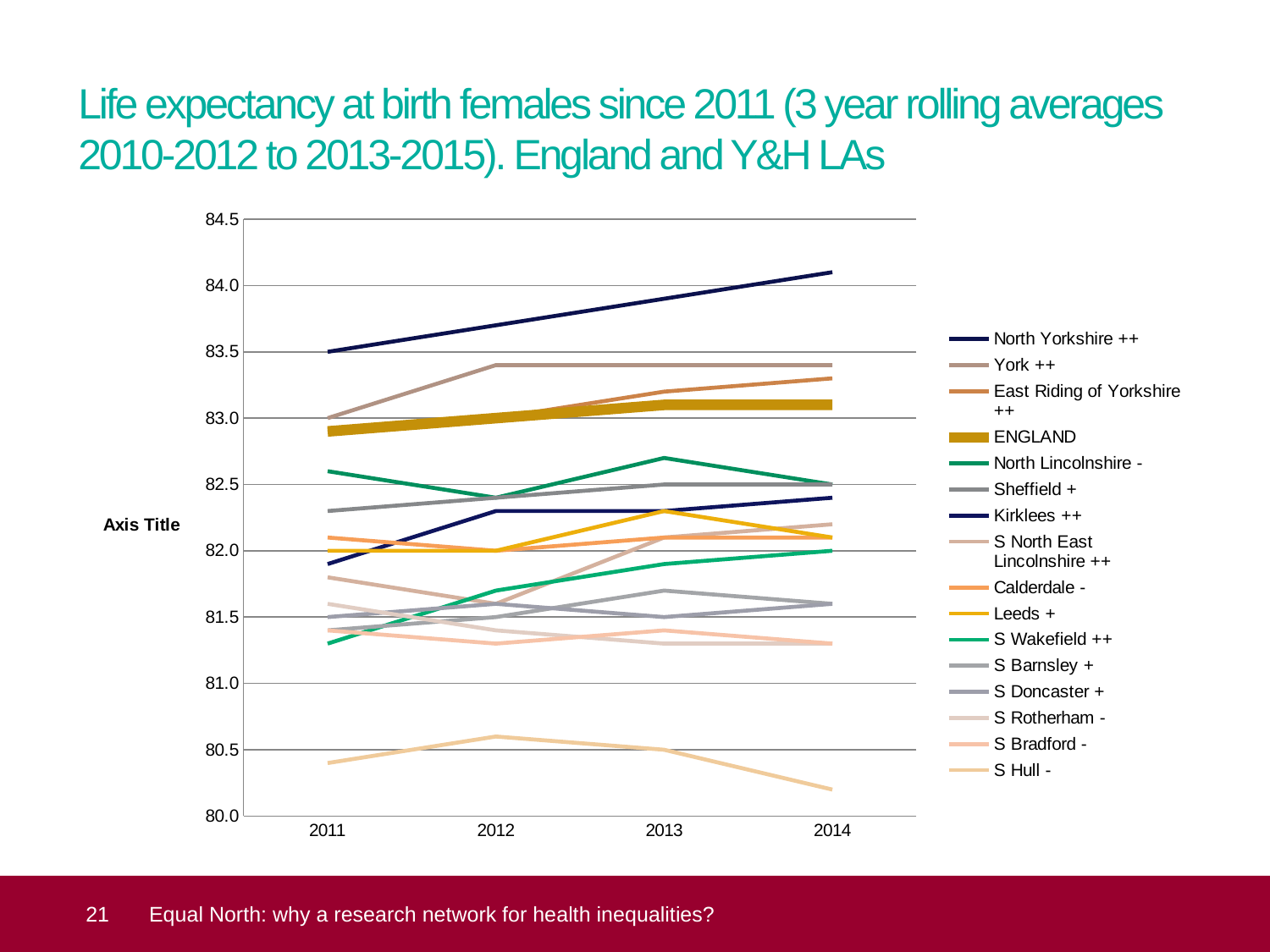
What is the label shown on the vertical axis? Axis Title How many series does the legend list? 16 Does the S Hull - line rise or fall from 2013 to 2014? fall Is the value for S Hull - in 2014 greater or less than 80.5? less Which series has the highest value in 2014? North Yorkshire ++ Is the value for York ++ in 2014 greater or less than 83.0? greater Does the North Yorkshire ++ line rise or fall from 2011 to 2014? rise Which series has the lowest value in 2014? S Hull - Is the value for North Yorkshire ++ in 2014 greater or less than 84.0? greater In 2012, which is higher: York ++ or ENGLAND? York ++ What kind of chart is shown on the slide? line chart How many years are shown along the x axis? 4